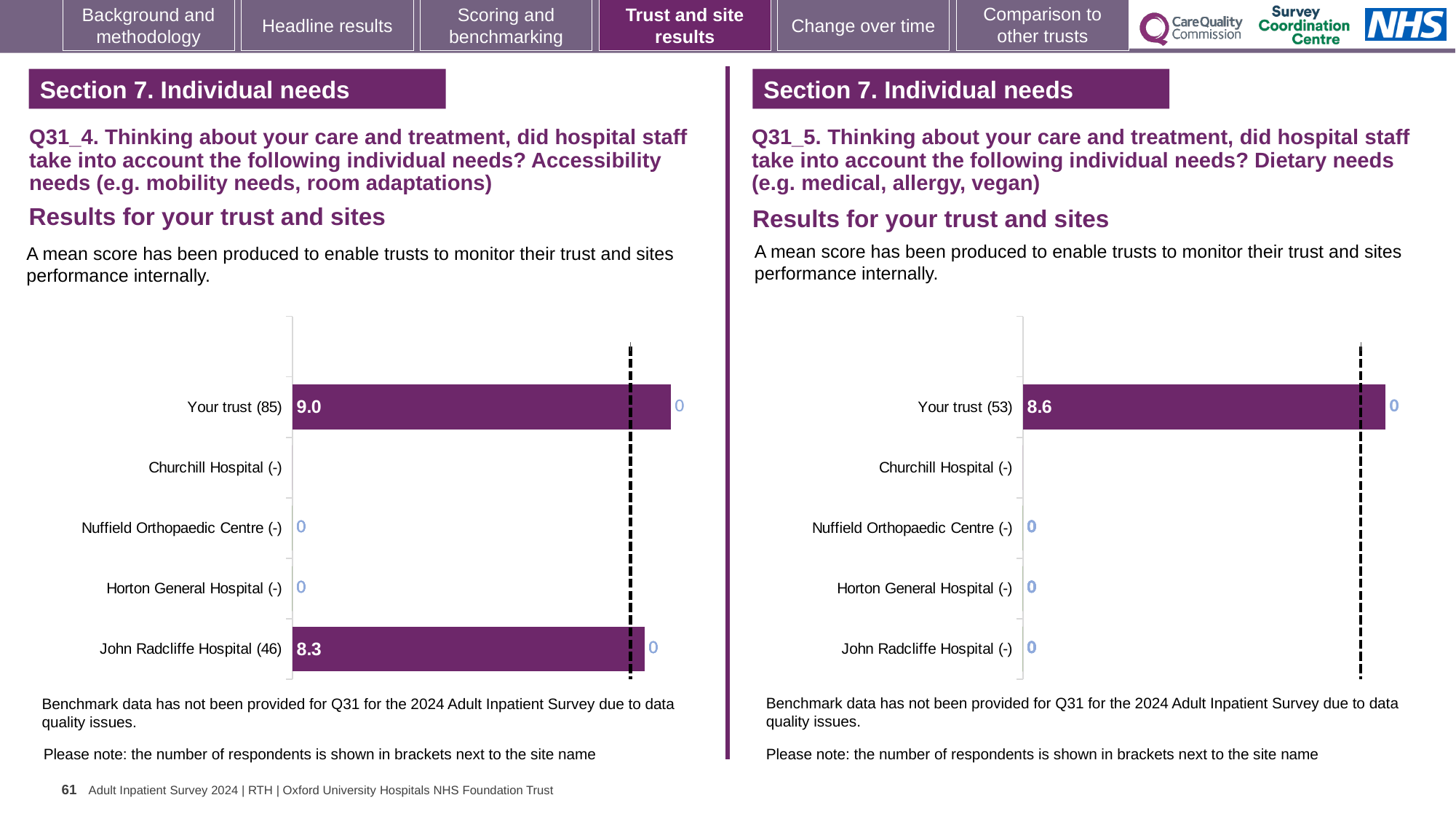
In the right chart (Q31_5, Dietary needs), how many respondents are shown in brackets for Your trust? 53 In the left chart (Q31_4, Accessibility needs), which category has the highest mean score? Your trust In the left chart (Q31_4, Accessibility needs), what is the difference between the mean score for Your trust and for John Radcliffe Hospital? 0.7 In the right chart (Q31_5, Dietary needs), what is the mean score for Your trust? 8.6 How many categories are listed on the axis of the right chart (Q31_5, Dietary needs)? 5 In the left chart (Q31_4, Accessibility needs), how many respondents are shown in brackets for John Radcliffe Hospital? 46 Which of the two charts shows a higher mean score for Your trust: the left chart (Q31_4, Accessibility needs) or the right chart (Q31_5, Dietary needs)? The left chart (Q31_4, Accessibility needs) What kind of chart is used in the left chart (Q31_4, Accessibility needs)? Bar chart In the left chart (Q31_4, Accessibility needs), what is the mean score for John Radcliffe Hospital? 8.3 In the left chart (Q31_4, Accessibility needs), what is the mean score for Your trust? 9.0 In the left chart (Q31_4, Accessibility needs), which has the higher mean score: Your trust or John Radcliffe Hospital? Your trust How many categories are listed on the axis of the left chart (Q31_4, Accessibility needs)? 5